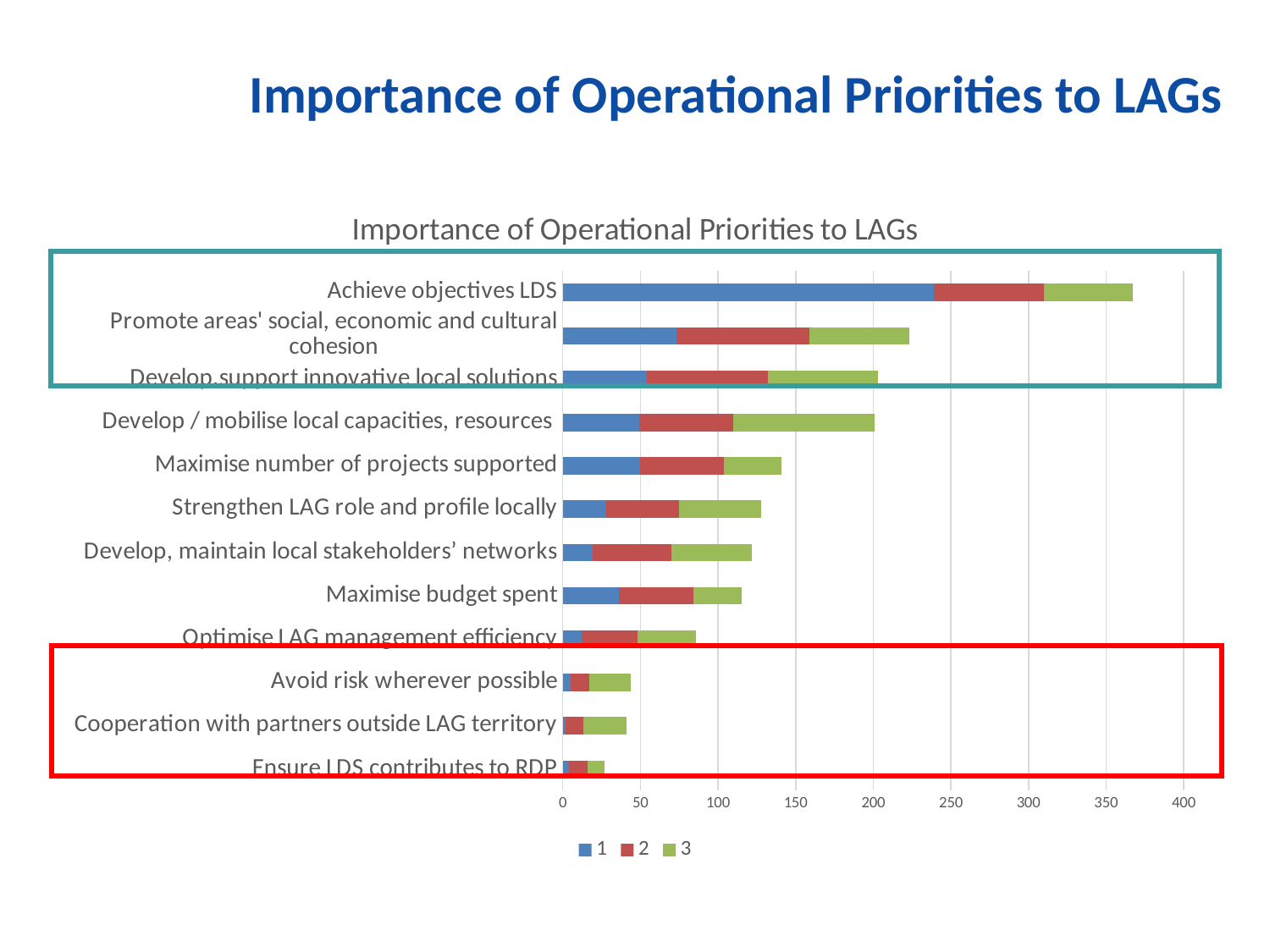
What kind of chart is shown on the slide? Stacked bar chart Which operational priority has the longest total bar? Achieve objectives LDS What are the legend entries of the chart? 1, 2, 3 How many series does the legend list? 3 Is the total bar for Achieve objectives LDS greater or less than 350? greater How many categories (operational priorities) are plotted in the chart? 12 Which operational priority has the shortest total bar? Ensure LDS contributes to RDP Which has the larger total bar: Maximise budget spent or Optimise LAG management efficiency? Maximise budget spent Is the total bar for Optimise LAG management efficiency greater or less than 100? less What is the title of the chart? Importance of Operational Priorities to LAGs Is the total bar for Avoid risk wherever possible greater or less than 50? less